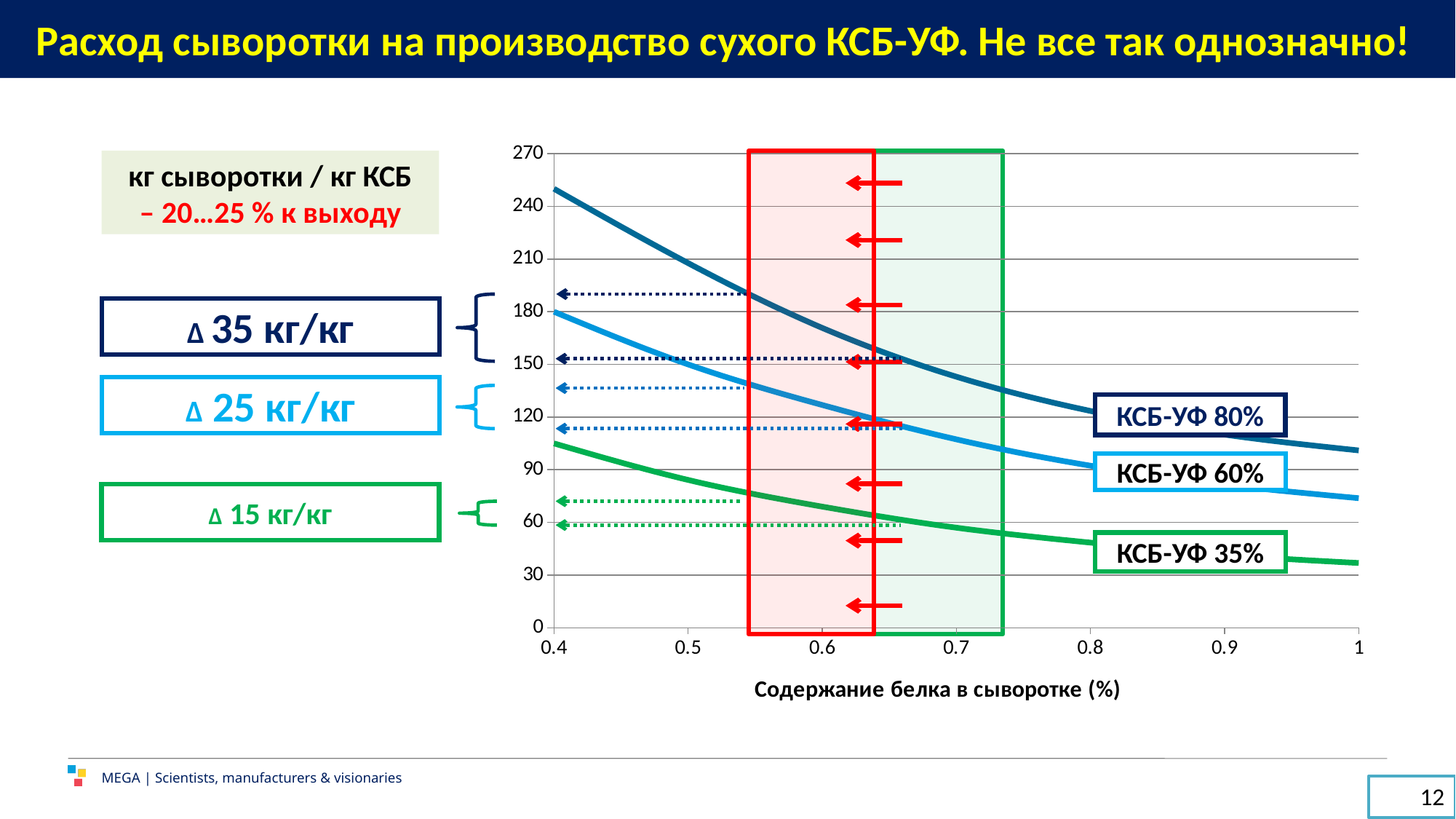
Which series has the lowest values across the whole x axis? КСБ-УФ 35% What is the maximum value shown on the y axis of the chart? 270 At protein content 0.8, which curve is higher: КСБ-УФ 60% or КСБ-УФ 35%? КСБ-УФ 60% Is the value of the КСБ-УФ 60% curve at protein content 0.4 greater or less than 210? less Is the value of the КСБ-УФ 35% curve at protein content 1 greater or less than 60? less What kind of chart is shown on the slide? line chart How many series (curves) are plotted on the chart? 3 How many tick labels are shown on the x axis? 7 Is the value of the КСБ-УФ 80% curve at protein content 0.4 greater or less than 240? greater What is the title of the x axis of the chart? Содержание белка в сыворотке (%) Which series has the highest values across the whole x axis? КСБ-УФ 80% Do the values of the КСБ-УФ 60% curve rise or fall as protein content in whey increases? fall